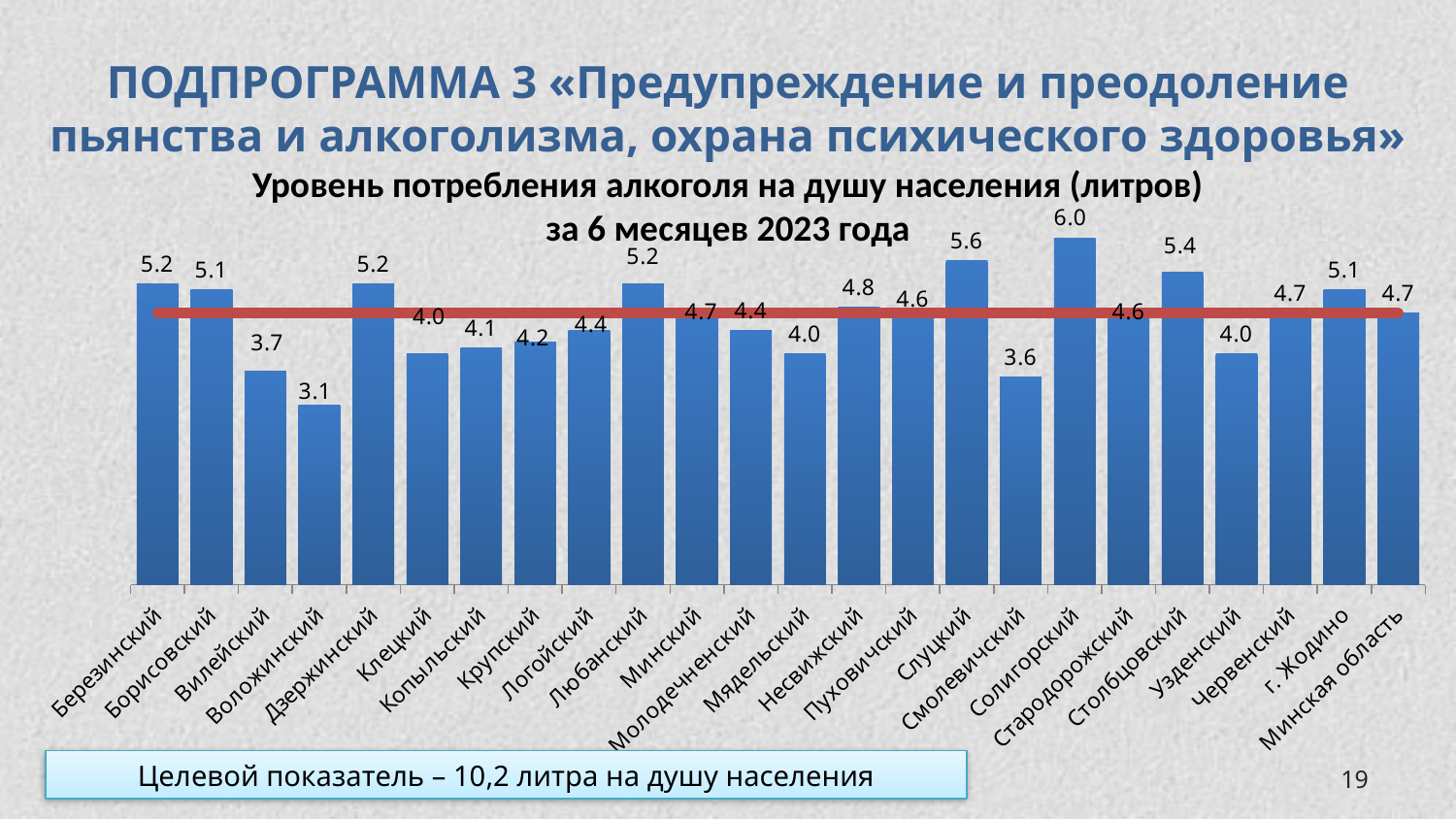
What is the difference between the values for Слуцкий and Столбцовский? 0.2 What is the title of the chart? Уровень потребления алкоголя на душу населения (литров) за 6 месяцев 2023 года What type of chart is shown on the slide? bar chart What is the value shown for Воложинский? 3.1 Which district has the highest alcohol consumption per capita? Солигорский What is the value shown for Минская область? 4.7 What is the difference between the values for Солигорский and Воложинский? 2.9 Which has a higher value, Вилейский or Несвижский? Несвижский What is the value shown for Смолевичский? 3.6 What is the alcohol consumption value for Солигорский? 6.0 Which district has the lowest alcohol consumption per capita? Воложинский How many categories (districts and regions) are shown on the x axis? 24